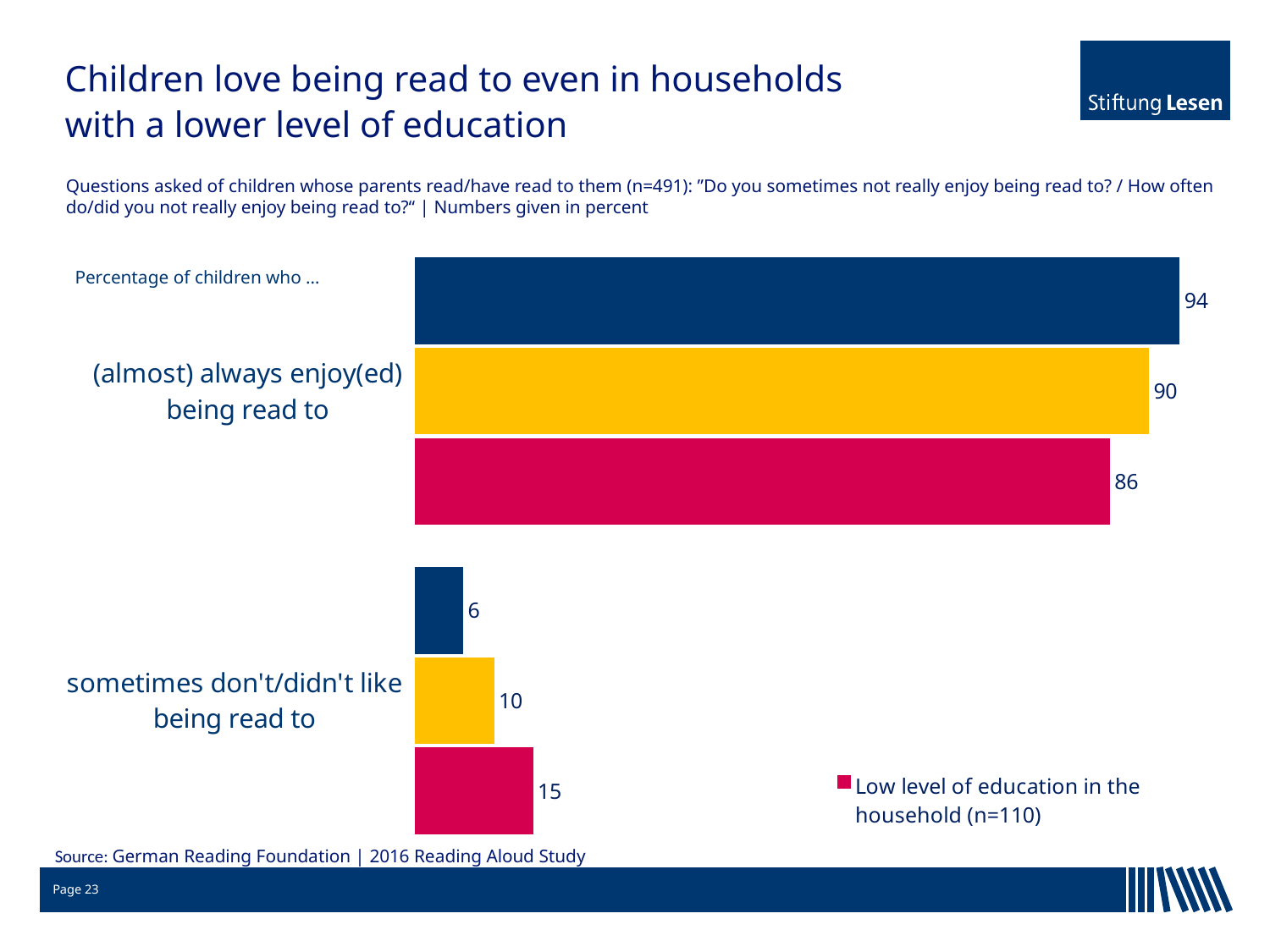
What value is shown on the yellow bar for "sometimes don't/didn't like being read to"? 10 For "sometimes don't/didn't like being read to", how much larger is the red bar for low level of education than the dark blue bar? 9 Among the three bars for "(almost) always enjoy(ed) being read to", which colour bar has the highest value? dark blue What is the value for "Low level of education in the household (n=110)" for "(almost) always enjoy(ed) being read to"? 86 What is the only series entry listed in the chart's legend? Low level of education in the household (n=110) What is the value for "Low level of education in the household (n=110)" for "sometimes don't/didn't like being read to"? 15 How many categories are shown on the chart? 2 Among the three bars for "sometimes don't/didn't like being read to", which colour bar has the lowest value? dark blue For the low level of education series, which is larger: the value for "(almost) always enjoy(ed) being read to" or for "sometimes don't/didn't like being read to"? (almost) always enjoy(ed) being read to For "(almost) always enjoy(ed) being read to", what is the difference between the dark blue bar (94) and the red bar for low level of education (86)? 8 What kind of chart is shown on the slide? bar chart What value is shown on the dark blue bar for "(almost) always enjoy(ed) being read to"? 94